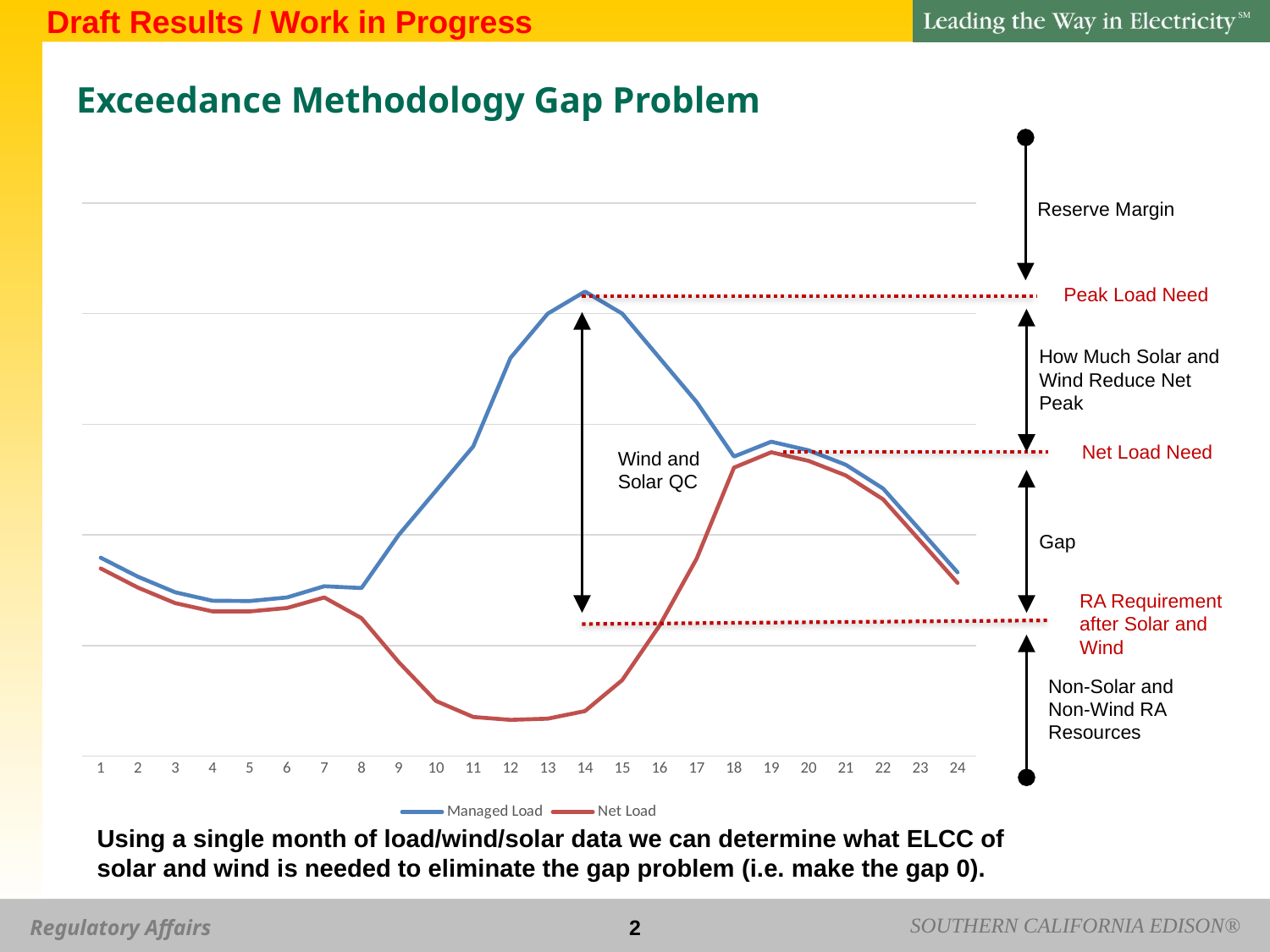
How many points are plotted along the x axis for each series? 24 Which colour is used for the Net Load series? Red At which x-axis value does the Net Load series reach its lowest point? 12 How many series does the legend list? 2 At x-axis value 14, which series has the higher value, Managed Load or Net Load? Managed Load Does the Net Load series rise or fall between x-axis values 19 and 24? Fall Does the Managed Load series rise or fall between x-axis values 8 and 14? Rise What are the two series named in the legend? Managed Load and Net Load What kind of chart is shown on the slide? Line chart At which x-axis value does the Net Load series reach its highest point? 19 Which series has the lower value at x-axis value 11, Managed Load or Net Load? Net Load At which x-axis value does the Managed Load series reach its highest point? 14